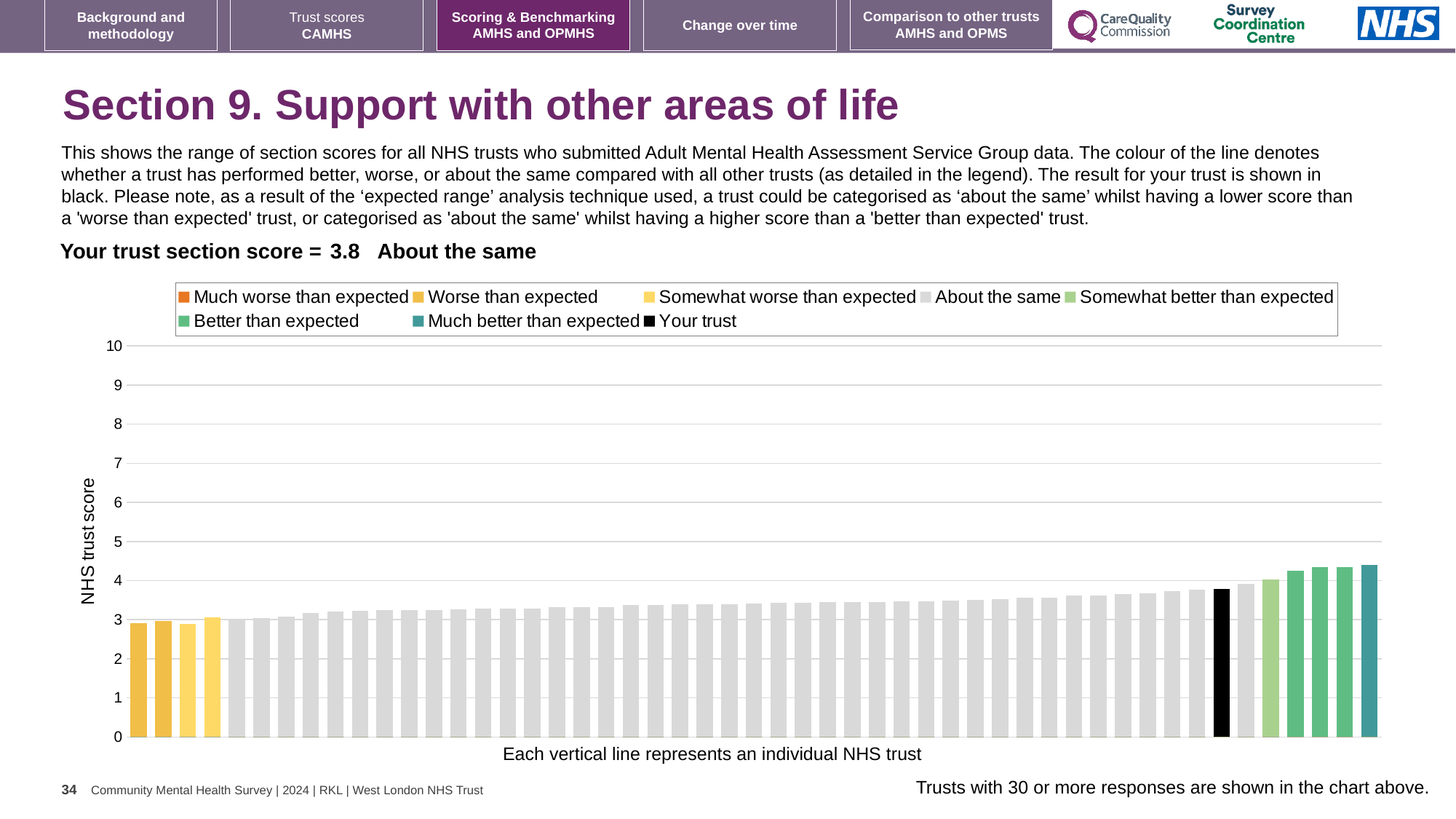
Is the value of the black 'Your trust' bar greater or less than 3? greater How many entries does the chart legend list? 8 What kind of chart is shown on the slide? bar chart What colour is the bar representing your trust? black What is the section score for your trust? 3.8 Is the value of the tallest bar in the chart greater or less than 4? greater Is the value of the black 'Your trust' bar greater or less than 4? less Do the bar values rise or fall from left to right along the x axis? rise Which category is your trust's section score placed in? About the same What is the label on the vertical axis of the chart? NHS trust score Which legend category does the tallest bar in the chart belong to? Much better than expected